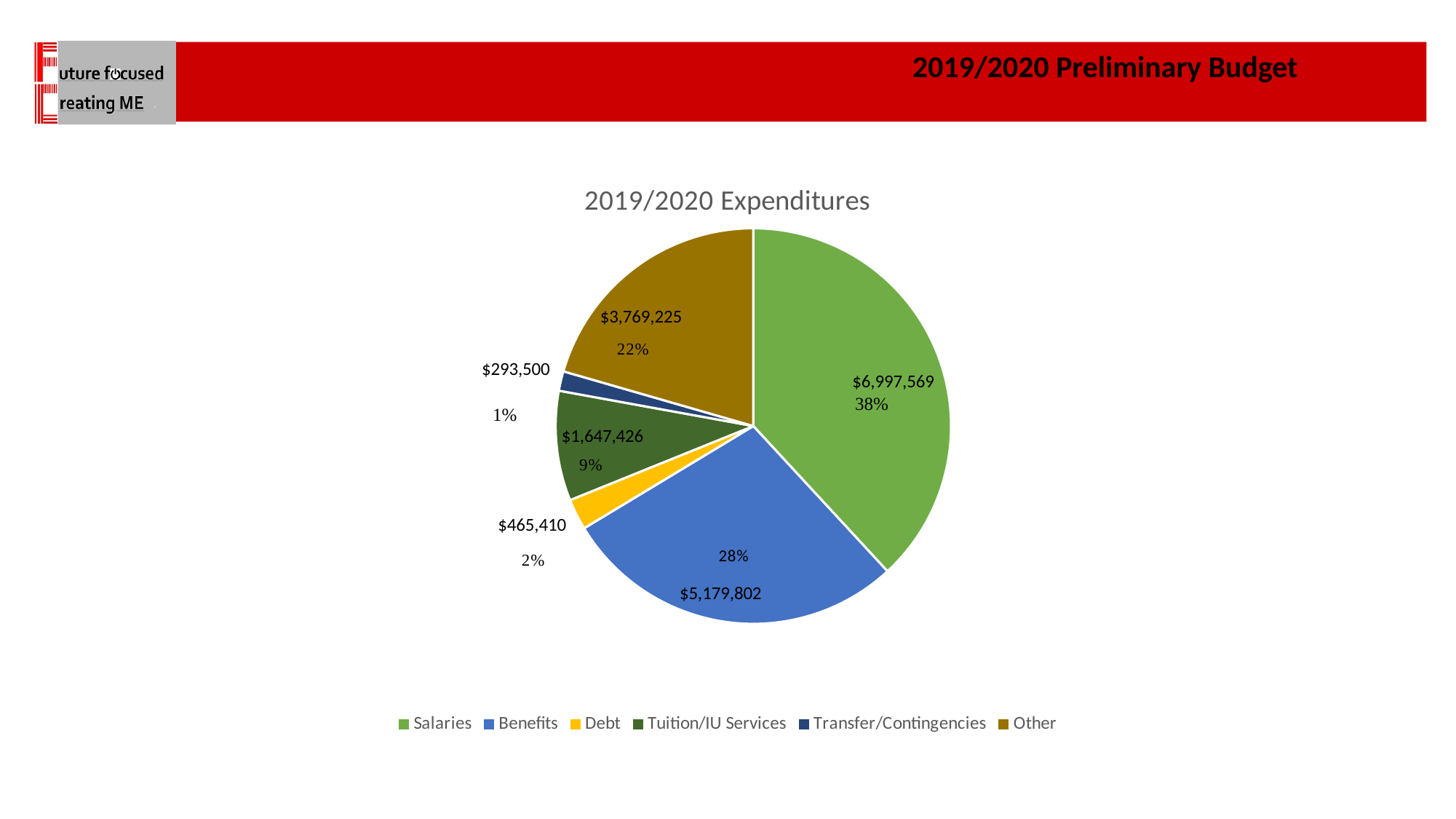
Which is larger, Tuition/IU Services or Other? Other Which category has the largest share of expenditures? Salaries How many categories does the legend list? 6 What is the difference between the Salaries and Benefits values? $1,817,767 Which category has the smallest share of expenditures? Transfer/Contingencies What is the value for Salaries? $6,997,569 What is the value for Debt? $465,410 What is the value for Benefits? $5,179,802 What percentage share of the pie does Other represent? 22% What is the value for Tuition/IU Services? $1,647,426 What is the value for Other? $3,769,225 What is the value for Transfer/Contingencies? $293,500